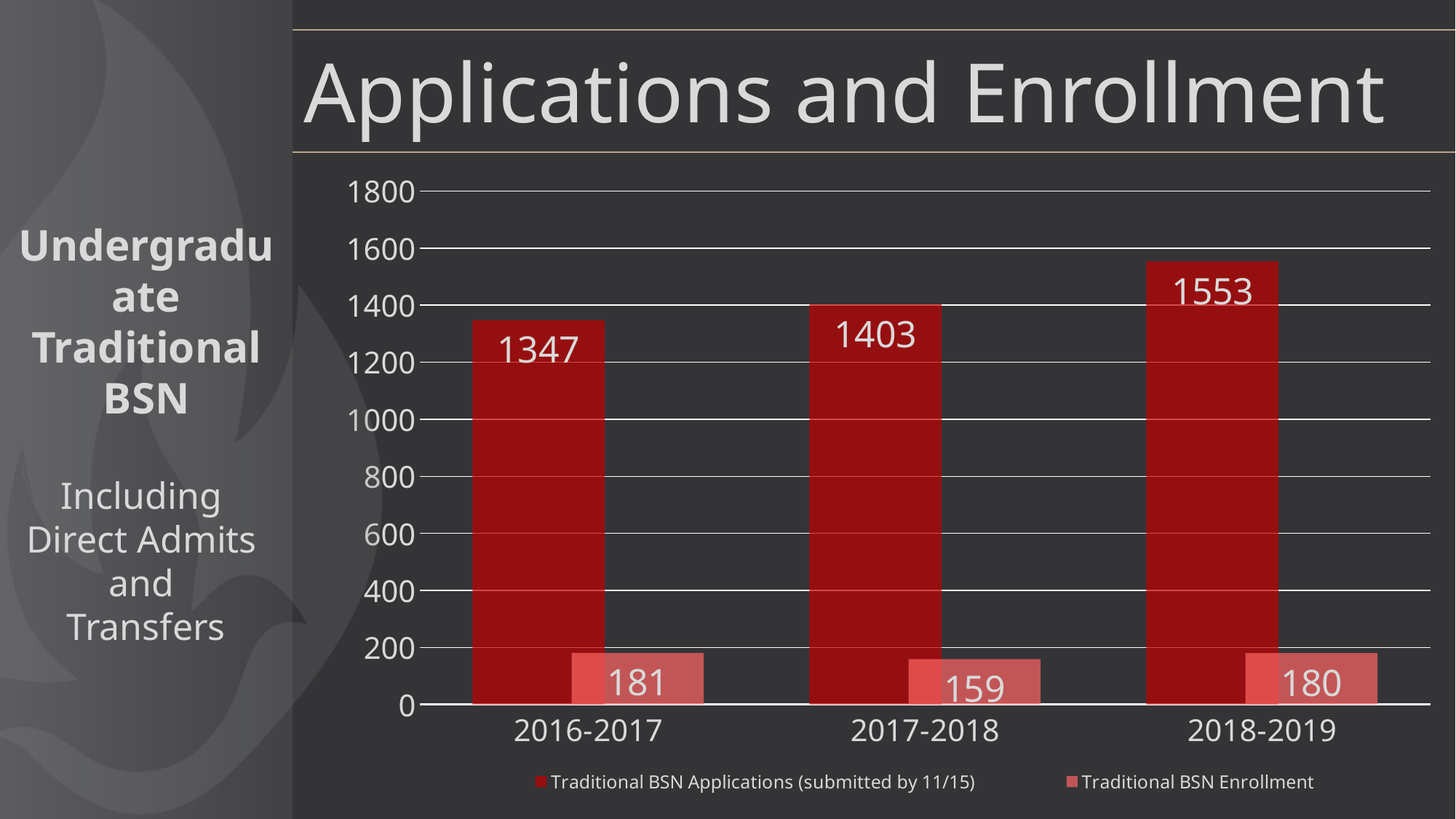
What kind of chart is shown on the slide? Bar chart Which year has the lowest Traditional BSN Enrollment? 2017-2018 What is the value of Traditional BSN Applications (submitted by 11/15) for 2018-2019? 1553 Which is larger: Traditional BSN Applications (submitted by 11/15) in 2016-2017 or in 2017-2018? 2017-2018 What is the difference between Traditional BSN Applications (submitted by 11/15) in 2018-2019 and 2017-2018? 150 Which year has the highest Traditional BSN Applications (submitted by 11/15)? 2018-2019 What is the difference between Traditional BSN Enrollment in 2016-2017 and 2017-2018? 22 What is the value of Traditional BSN Applications (submitted by 11/15) for 2016-2017? 1347 What is the value of Traditional BSN Enrollment for 2017-2018? 159 Do Traditional BSN Applications (submitted by 11/15) rise or fall from 2016-2017 to 2018-2019? Rise How many series does the legend list? 2 How many years are shown on the x axis? 3